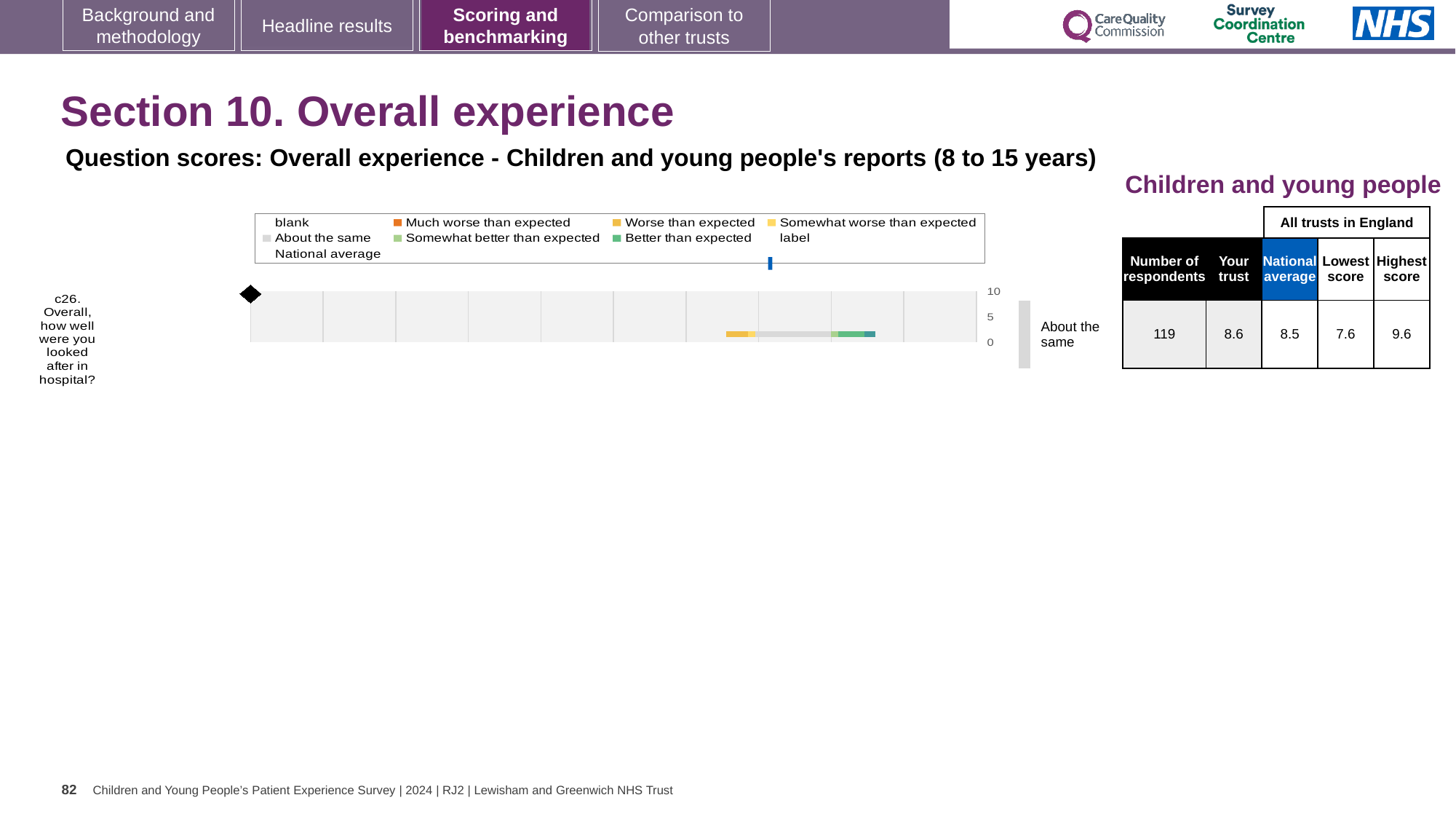
What is the difference between the highest score and the lowest score for c26 in the table beside the chart? 2.0 According to the table beside the chart, what is the national average score for question c26? 8.5 According to the table beside the chart, what is the 'Your trust' score for question c26? 8.6 What kind of chart is used to show the question score for c26? bar chart What is the highest value shown on the chart's axis? 10 Which question is plotted on the chart? c26. Overall, how well were you looked after in hospital? According to the table beside the chart, what is the lowest score among all trusts in England for question c26? 7.6 How many survey questions are plotted on the chart? 1 Is the 'Your trust' score for c26 larger or smaller than the national average? larger According to the table beside the chart, what is the highest score among all trusts in England for question c26? 9.6 According to the table beside the chart, how many respondents answered question c26? 119 What is the benchmark category shown next to the bar for question c26? About the same